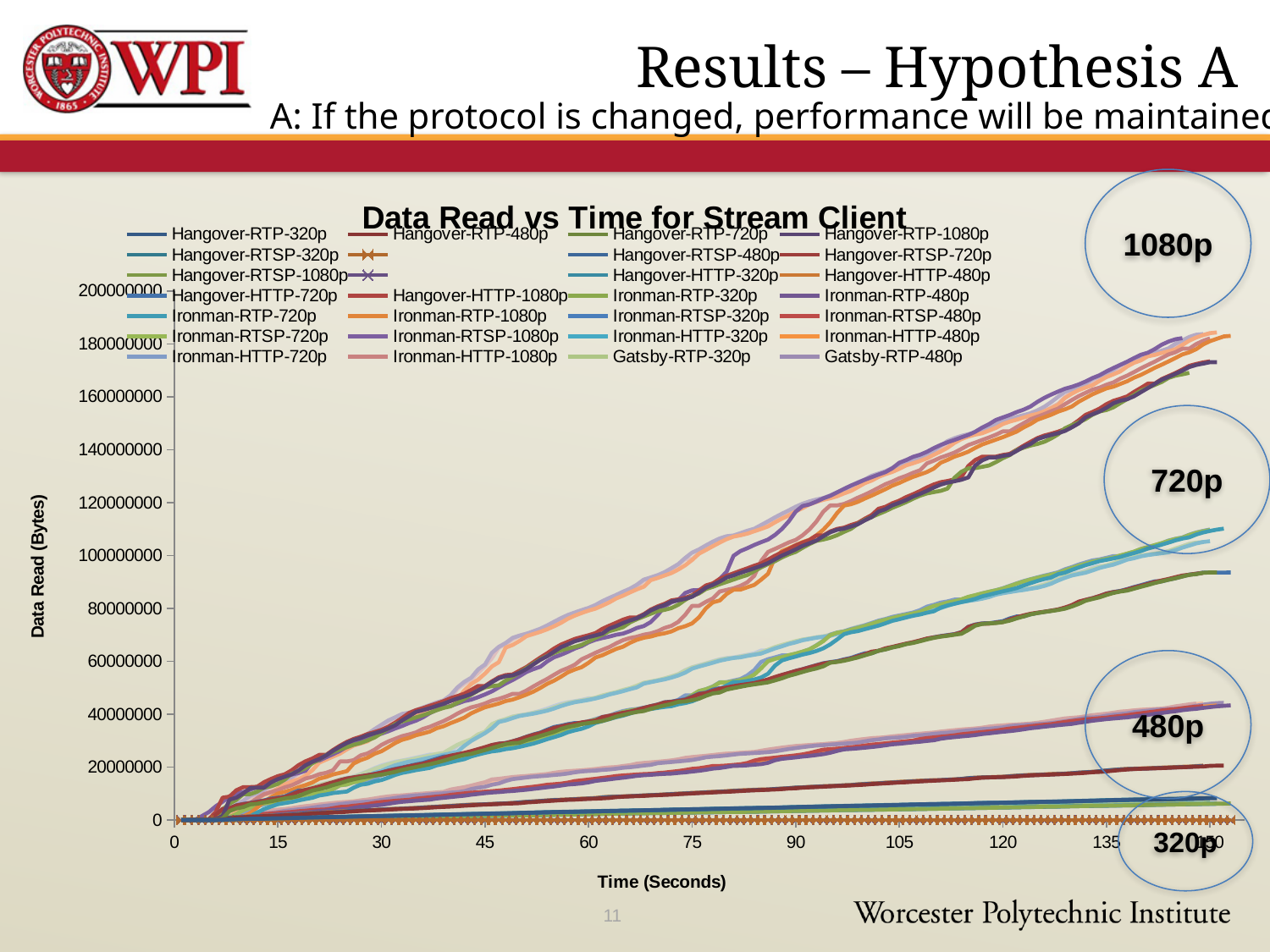
What is the title of the chart? Data Read vs Time for Stream Client Do the plotted lines rise or fall as time increases along the x axis? rise Which resolution group, as labelled by the circled annotations, reaches the highest data read by the end of the chart? 1080p Which resolution group, as labelled by the circled annotations, has the lowest data read by the end of the chart? 320p What kind of chart is shown on the slide? line chart What is the label of the y axis of the chart? Data Read (Bytes) Which group reaches a higher data read by the end of the chart, the 720p group or the 480p group? 720p Is the data read for the 1080p group at the right end of the chart greater or less than 160000000? greater What is the highest value shown on the y axis of the chart? 200000000 Is the data read for the 720p group at the right end of the chart greater or less than 80000000? greater Is the data read for the 480p group at the right end of the chart greater or less than 60000000? less